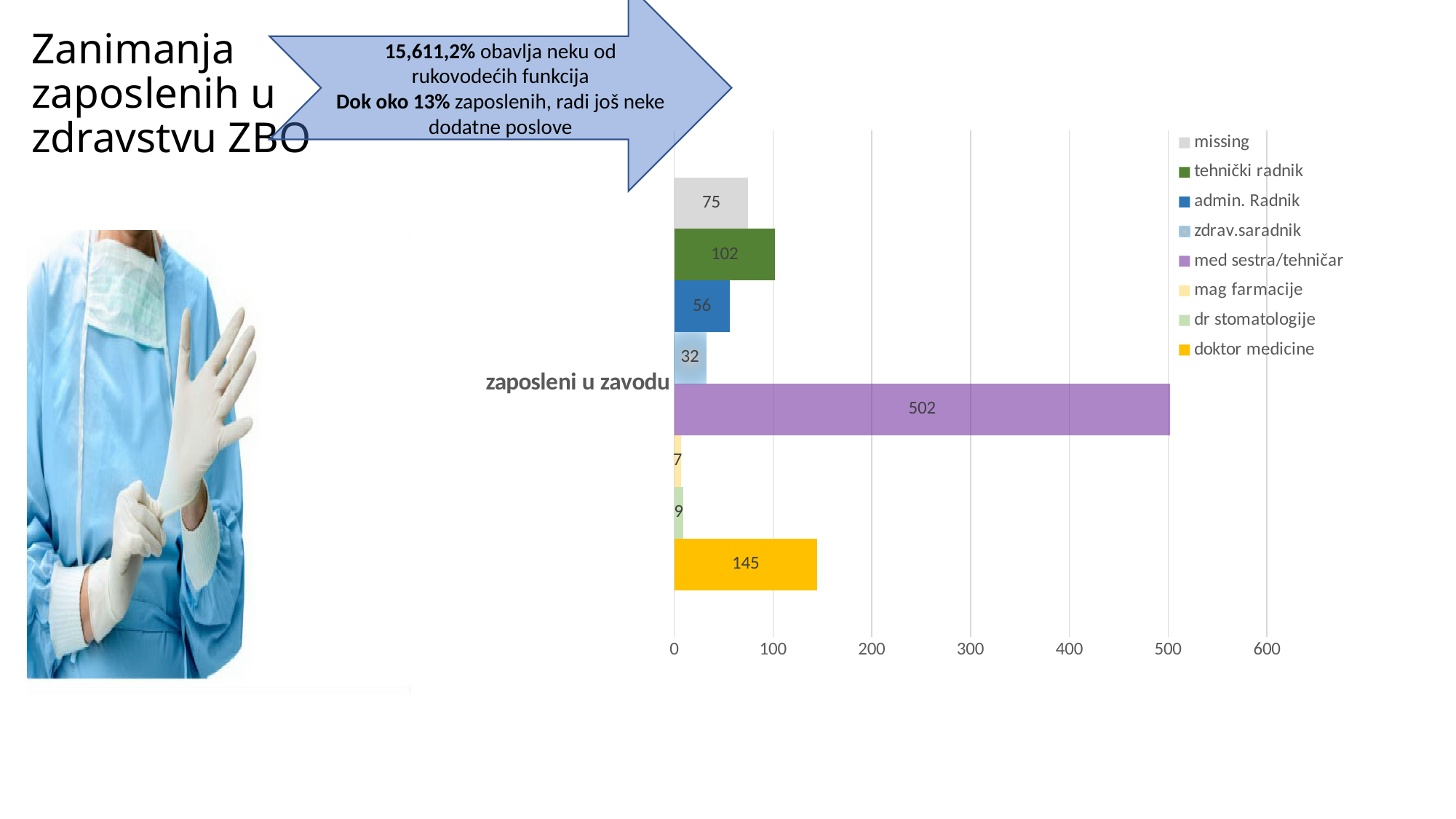
Is the value for med sestra/tehničar greater or less than 400? greater What is the value for admin. Radnik? 56 Which series has the lowest value? mag farmacije Which is larger, the value for missing or the value for admin. Radnik? missing What is the value for med sestra/tehničar? 502 What kind of chart is shown on the slide? bar chart What is the value for tehnički radnik? 102 What is the value for doktor medicine? 145 How many series does the legend list? 8 What is the difference between the values for med sestra/tehničar and doktor medicine? 357 Which series has the highest value? med sestra/tehničar What is the category label shown on the vertical axis of the chart? zaposleni u zavodu